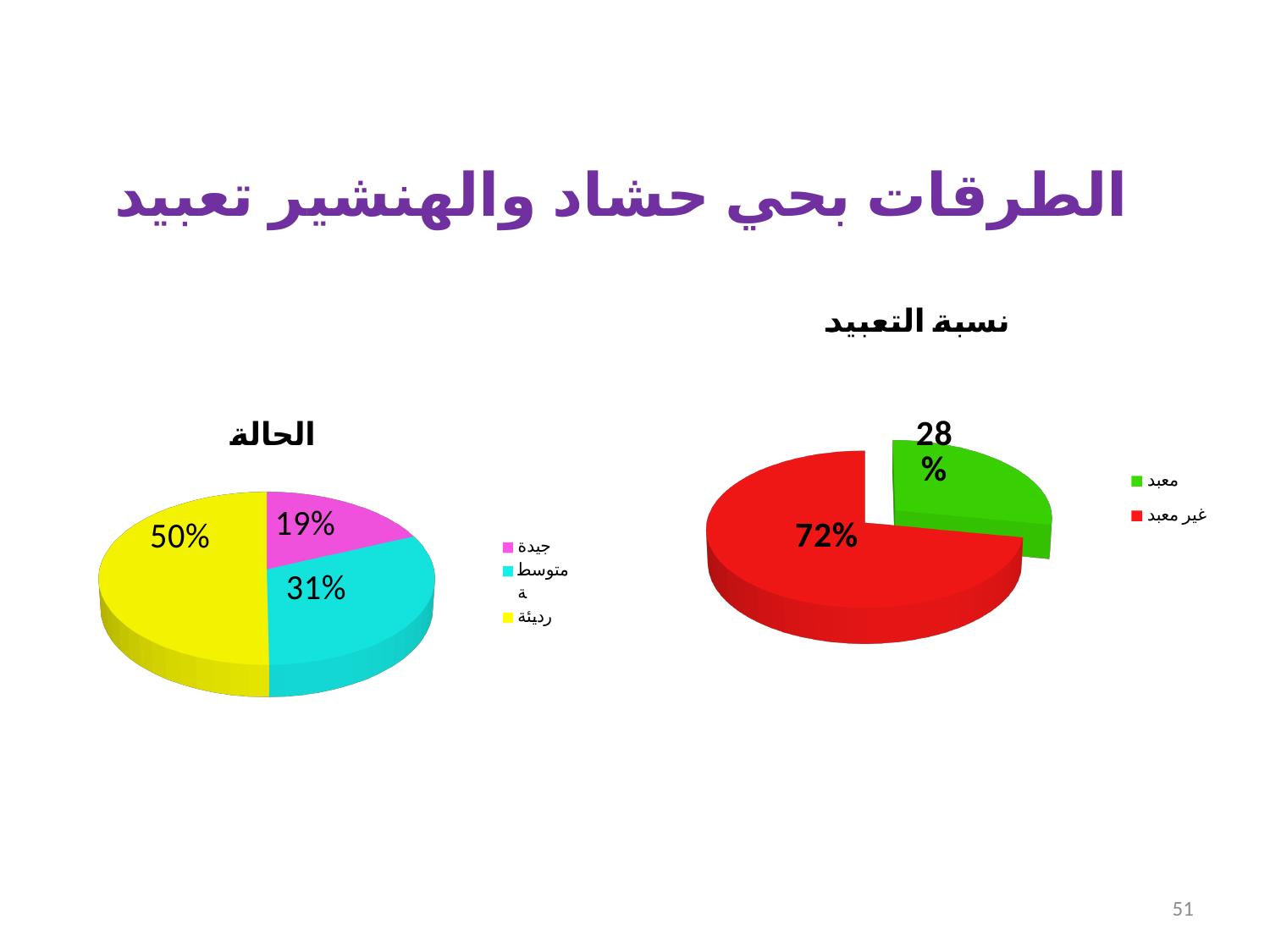
In the chart titled "الحالة", what percentage is shown for "رديئة"? 50% What type of chart is the chart titled "نسبة التعبيد"? Pie chart How many categories does the chart titled "الحالة" show? 3 In the chart titled "نسبة التعبيد", what percentage is shown for "معبد"? 28% In the chart titled "نسبة التعبيد", which category has the larger share, "معبد" or "غير معبد"? غير معبد In the chart titled "الحالة", which category has the largest share? رديئة In the chart titled "الحالة", which category has the smallest share? جيدة In the chart titled "الحالة", what percentage is shown for "جيدة"? 19% In the chart titled "نسبة التعبيد", what percentage is shown for "غير معبد"? 72% In the chart titled "الحالة", what percentage is shown for "متوسطة"? 31% In the chart titled "الحالة", what is the difference in percentage points between "رديئة" and "متوسطة"? 19 In the chart titled "نسبة التعبيد", what is the difference in percentage points between "غير معبد" and "معبد"? 44